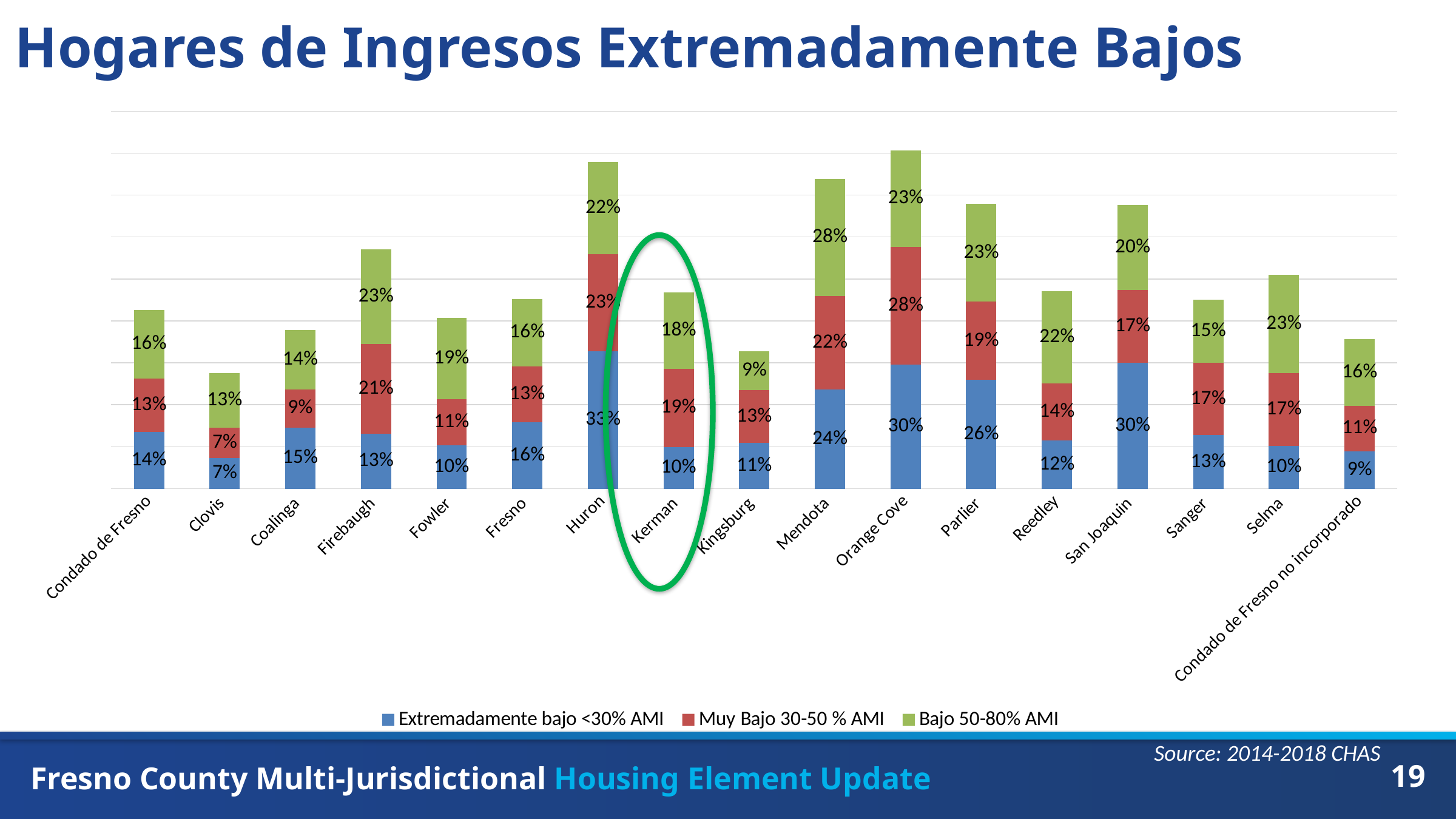
What is the total of the three stacked segments for Kerman? 47% How many jurisdictions (categories) are shown on the x axis? 17 What is the Muy Bajo 30-50 % AMI value for Firebaugh? 21% What is the Bajo 50-80% AMI value for Mendota? 28% Which jurisdiction has the lowest Bajo 50-80% AMI value? Kingsburg What is the Extremadamente bajo <30% AMI value for Kerman? 10% What is the difference between the Extremadamente bajo <30% AMI values for Orange Cove and Clovis? 23% How many series does the legend list? 3 Which jurisdiction is circled in green on the chart? Kerman Which jurisdiction has the highest Extremadamente bajo <30% AMI value? Huron What kind of chart is shown on the slide? Stacked bar chart Which has a larger Muy Bajo 30-50 % AMI value, Orange Cove or Reedley? Orange Cove